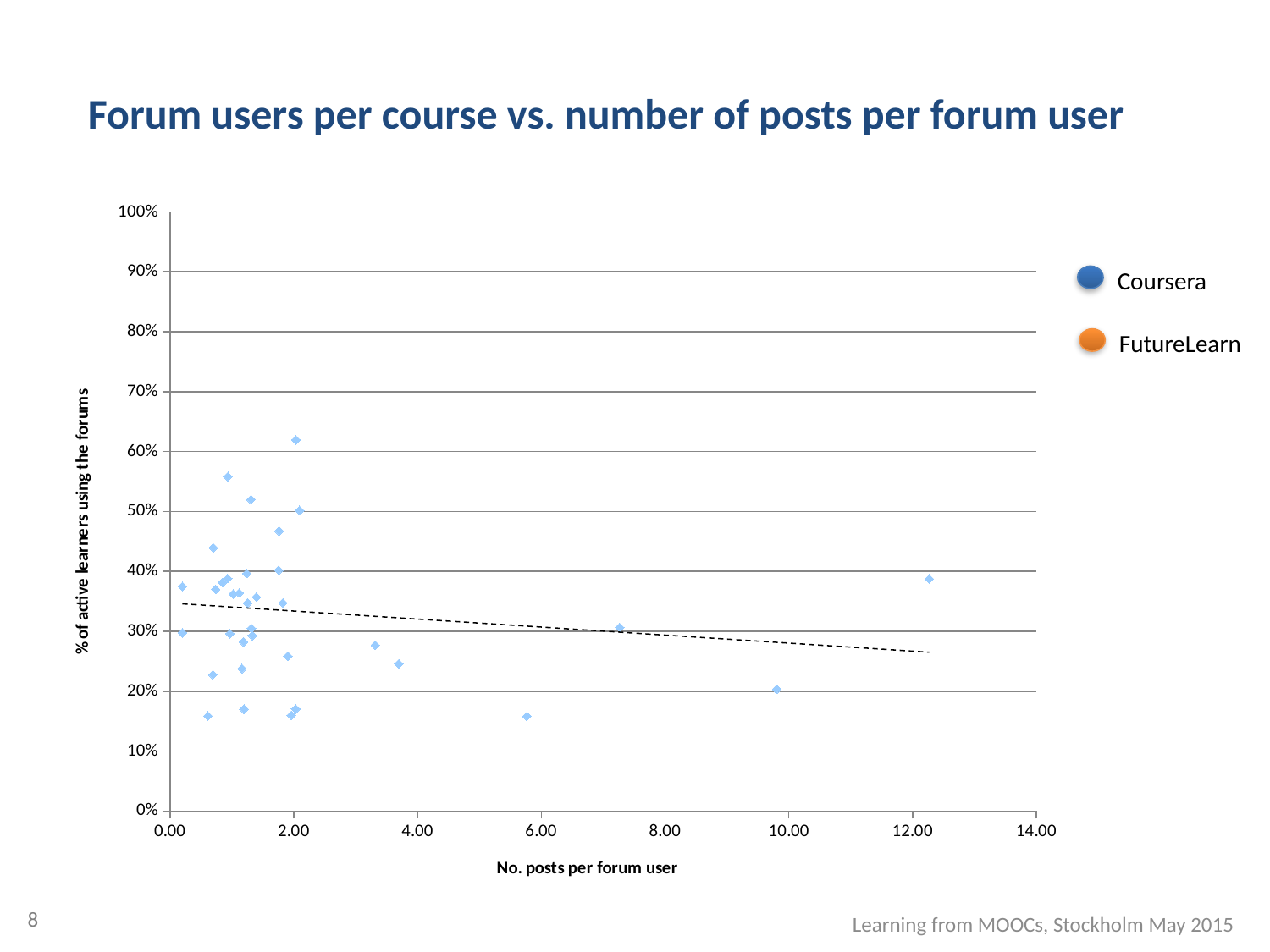
What is the highest value shown on the x axis? 14.00 What kind of chart is shown on the slide? scatter chart Is the y value of the highest point on the chart greater or less than 60%? greater Is the y value of the point at about 10 posts per forum user greater or less than 30%? less Is the y value of the point at about 6 posts per forum user greater or less than 20%? less How many entries does the legend list? 2 What is the title of the chart? Forum users per course vs. number of posts per forum user What is the label of the x axis? No. posts per forum user Does the dashed trend line rise or fall as the number of posts per forum user increases? fall